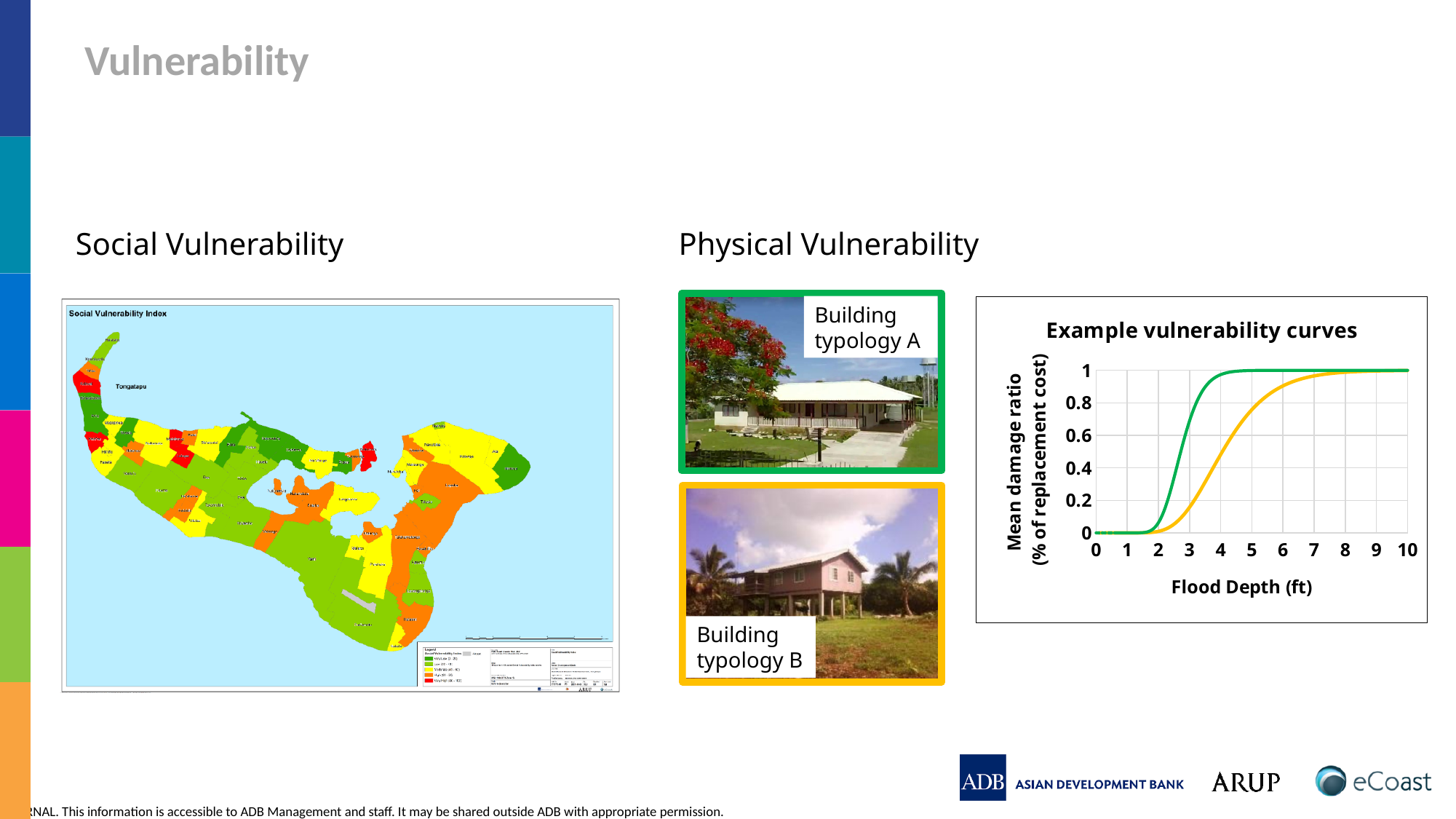
In the 'Example vulnerability curves' chart, is the green curve's value at a flood depth of 3 ft greater or less than 0.6? greater What is the x-axis label of the 'Example vulnerability curves' chart? Flood Depth (ft) In the 'Example vulnerability curves' chart, do the curves rise or fall as flood depth increases? rise In the 'Example vulnerability curves' chart, is the yellow curve's value at a flood depth of 2 ft greater or less than 0.2? less What is the maximum value shown on the x axis of the 'Example vulnerability curves' chart? 10 What kind of chart is 'Example vulnerability curves'? line chart In the 'Example vulnerability curves' chart, is the green curve's value at a flood depth of 5 ft greater or less than 0.8? greater In the 'Example vulnerability curves' chart, which curve reaches a mean damage ratio of 1 at a lower flood depth, the green or the yellow one? green In the 'Example vulnerability curves' chart, at a flood depth of 3 ft, which curve has the higher mean damage ratio, the green or the yellow one? green What is the title of the chart on the right of the slide? Example vulnerability curves How many curves are plotted in the 'Example vulnerability curves' chart? 2